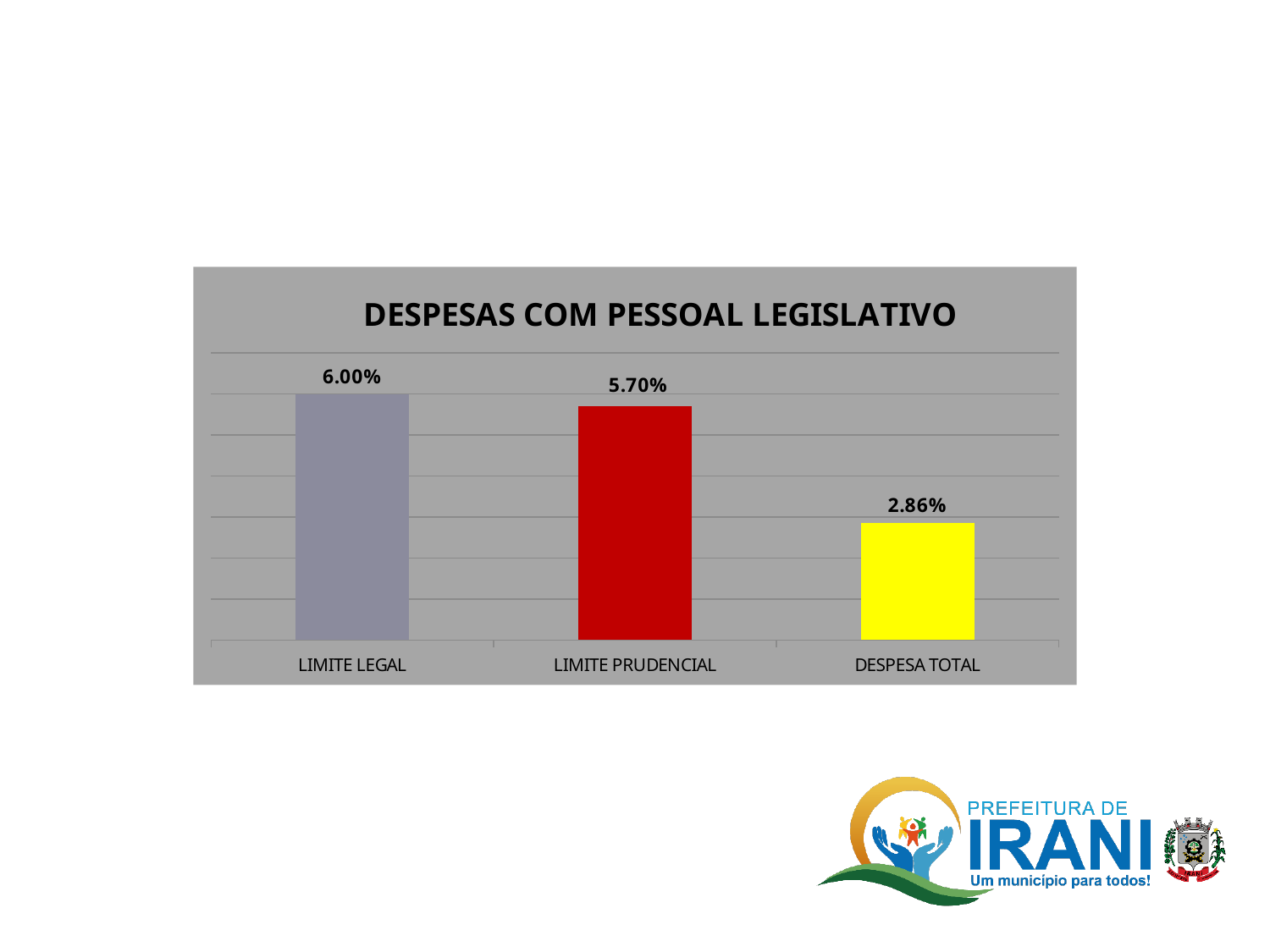
Which category has the lowest value? DESPESA TOTAL What is the value for LIMITE PRUDENCIAL? 5.70% How many categories are shown on the chart? 3 What is the value for DESPESA TOTAL? 2.86% What is the difference between LIMITE LEGAL and LIMITE PRUDENCIAL? 0.30% Do the values rise or fall from left to right across the categories? Fall Which is larger, LIMITE PRUDENCIAL or DESPESA TOTAL? LIMITE PRUDENCIAL What is the value for LIMITE LEGAL? 6.00% What kind of chart is shown on the slide? Bar chart What is the title of the chart? DESPESAS COM PESSOAL LEGISLATIVO Which category has the highest value? LIMITE LEGAL What is the difference between LIMITE PRUDENCIAL and DESPESA TOTAL? 2.84%